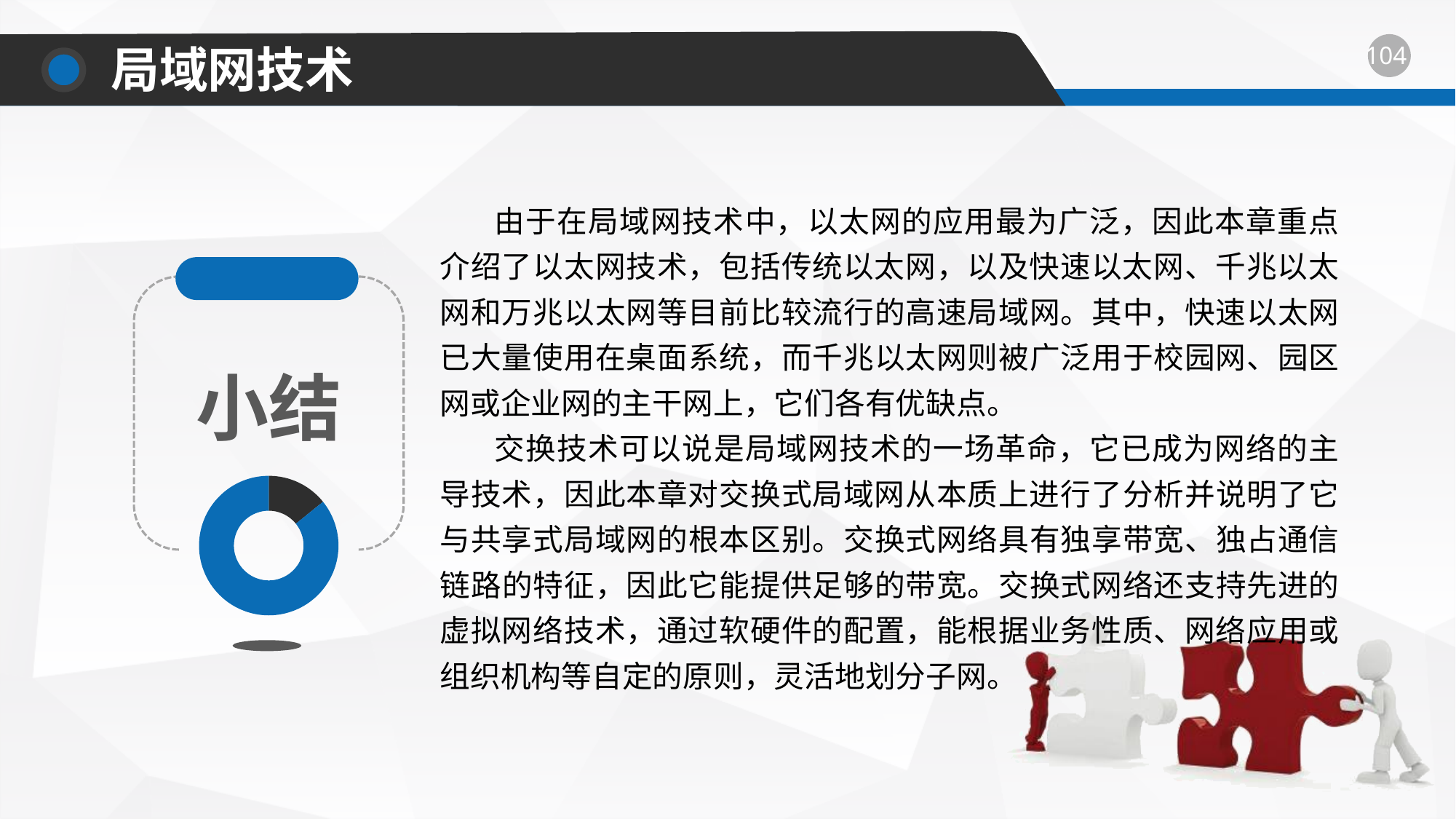
What kind of chart is shown on the left side of the slide below the text 小结? donut chart Does the donut chart on the left of the slide show any data labels or a legend? No In the donut chart on the left of the slide, which segment is larger, the blue one or the dark grey one? the blue one How many segments does the donut chart on the left of the slide have? 2 What colour is the larger segment of the donut chart on the left of the slide? blue